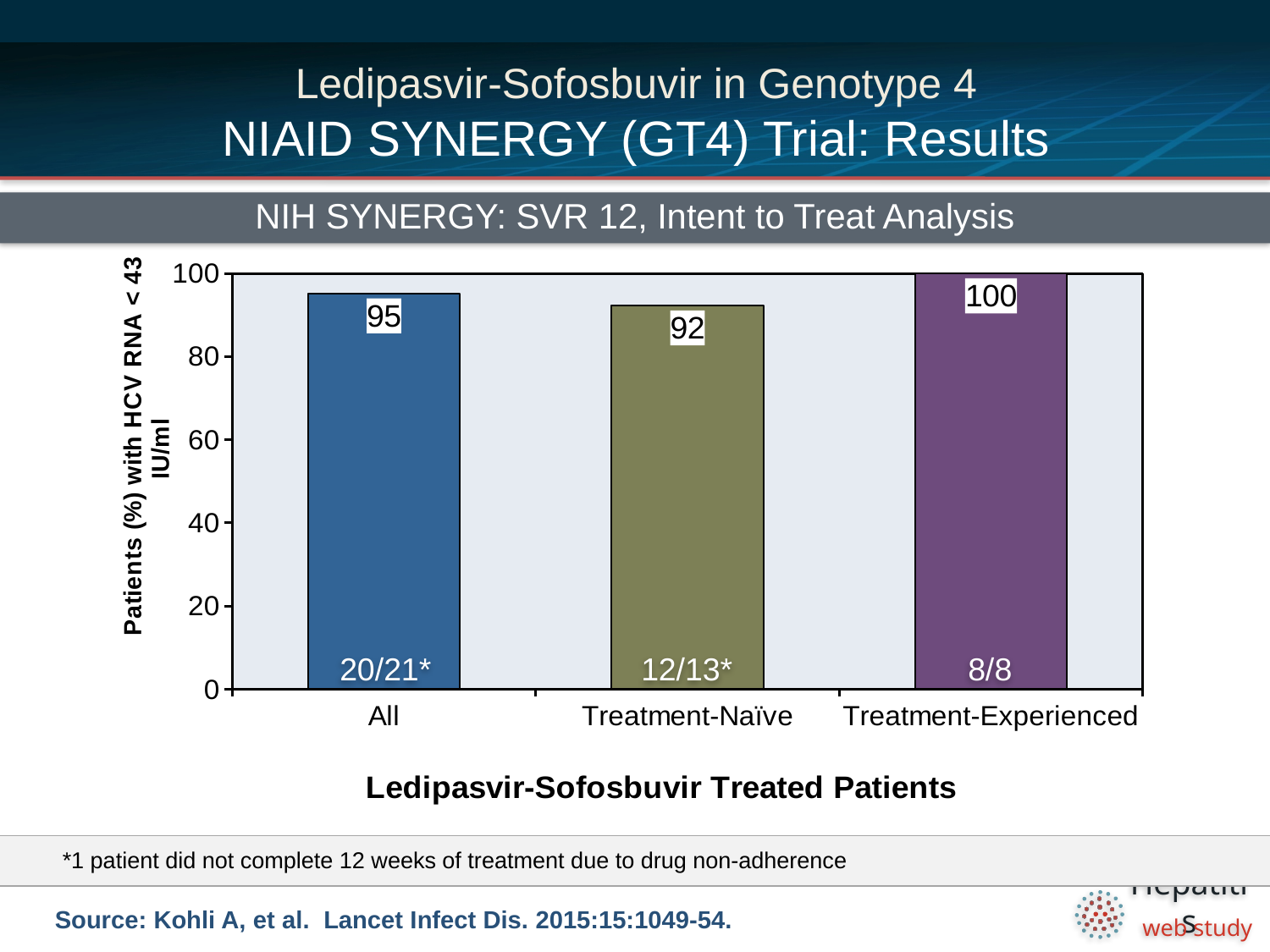
What is the SVR 12 value for the Treatment-Naïve group? 92 What is the difference between the SVR 12 values for Treatment-Experienced and Treatment-Naïve? 8 Which group has the highest SVR 12 value? Treatment-Experienced What is the title of the chart? NIH SYNERGY: SVR 12, Intent to Treat Analysis What is the difference between the SVR 12 values for All and Treatment-Naïve? 3 Which group has the lowest SVR 12 value? Treatment-Naïve What is the SVR 12 value for the All group? 95 What fraction of patients is printed on the bar for the Treatment-Experienced group? 8/8 How many patient groups are shown on the x axis? 3 What is the SVR 12 value for the Treatment-Experienced group? 100 Which is larger, the value for All or the value for Treatment-Experienced? Treatment-Experienced What kind of chart is shown on the slide? Bar chart